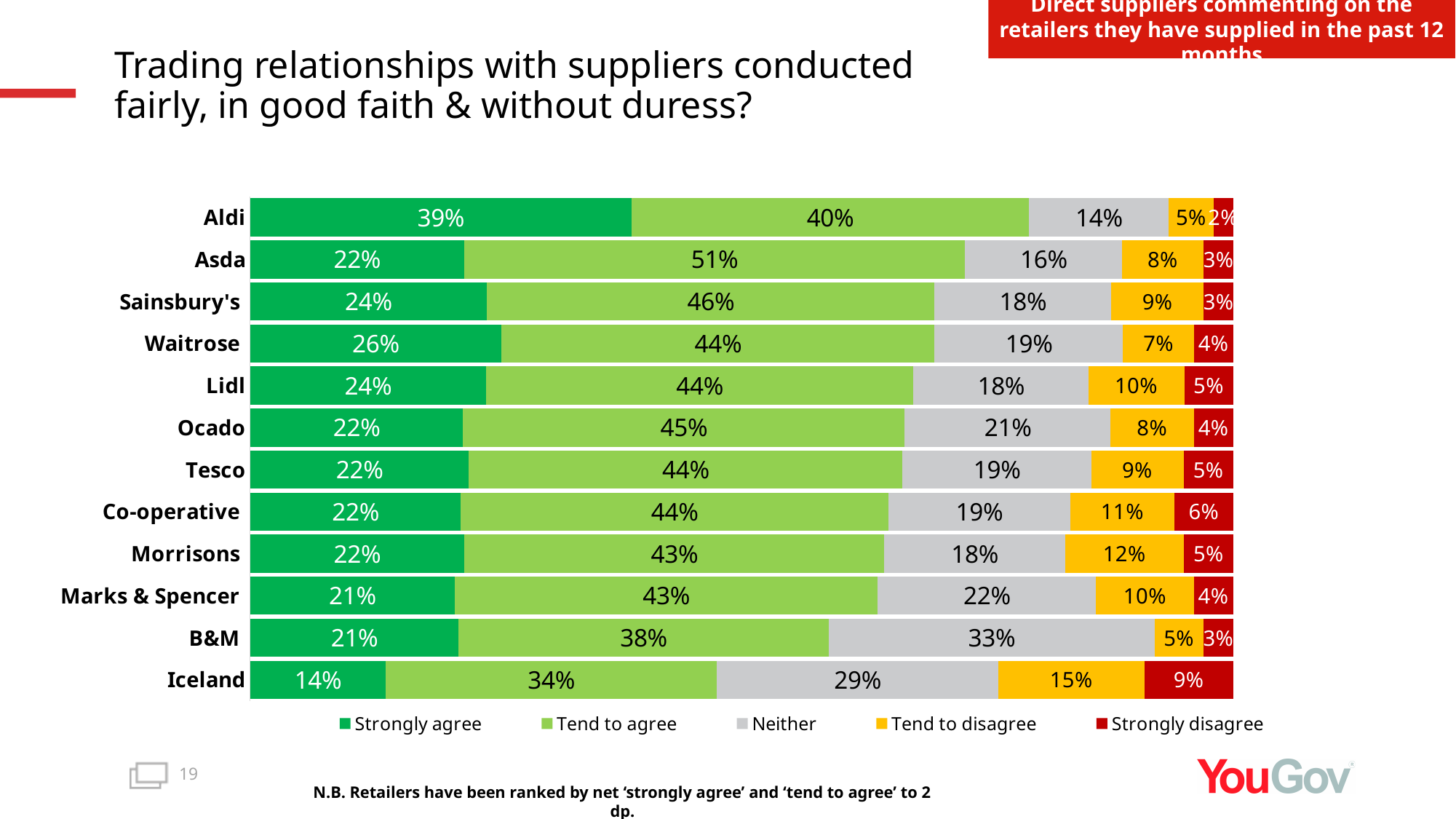
What is the combined 'Strongly agree' and 'Tend to agree' value for Aldi? 79% What is the 'Neither' value for B&M? 33% Which retailer has the lowest 'Strongly agree' value? Iceland Which is larger, the 'Neither' value for Ocado or for Marks & Spencer? Marks & Spencer What kind of chart is shown on the slide? Stacked bar chart How many series does the legend list? 5 What is the 'Strongly disagree' value for Iceland? 9% Which retailer has the highest 'Strongly agree' value? Aldi What is the 'Strongly agree' value for Aldi? 39% How many retailers are listed on the chart? 12 What is the 'Tend to agree' value for Asda? 51% What is the difference between the 'Tend to disagree' values for Iceland and Aldi? 10%